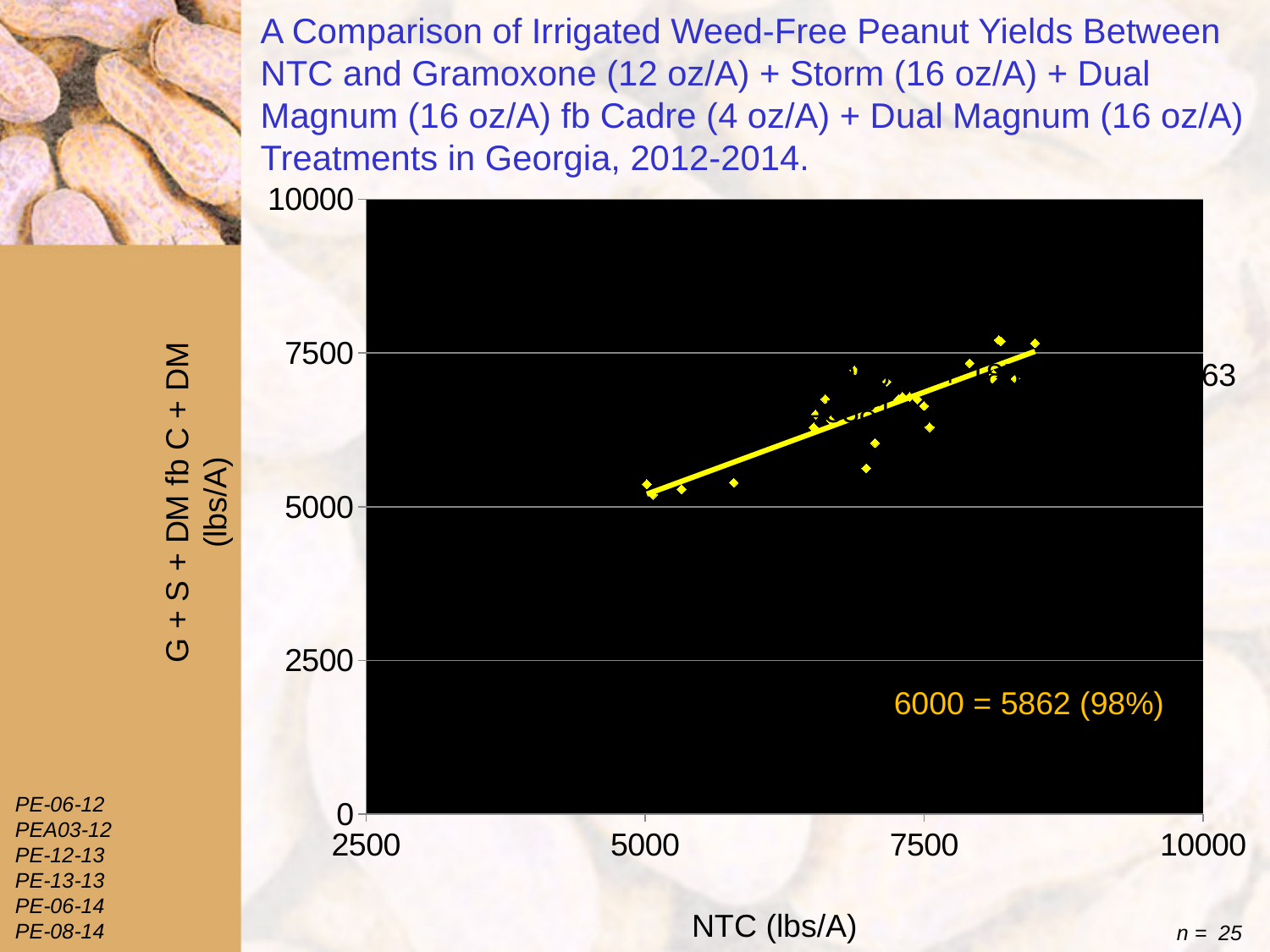
How many data points are plotted, according to the n value shown on the slide? 25 What is the label of the x axis? NTC (lbs/A) What kind of chart is shown on the slide? scatter chart Are all the plotted points greater or less than 10000 on the x axis? less What is the label of the y axis? G + S + DM fb C + DM (lbs/A) According to the annotation on the chart, what treatment yield corresponds to an NTC yield of 6000? 5862 (98%) What is the lowest value shown on the x axis? 2500 What is the highest value shown on the y axis? 10000 According to the trend line, do the treatment yields rise or fall as NTC yield increases along the x axis? rise Are all the plotted points greater or less than 5000 on the y axis? greater Is the lowest plotted point's x value greater or less than 7500? less